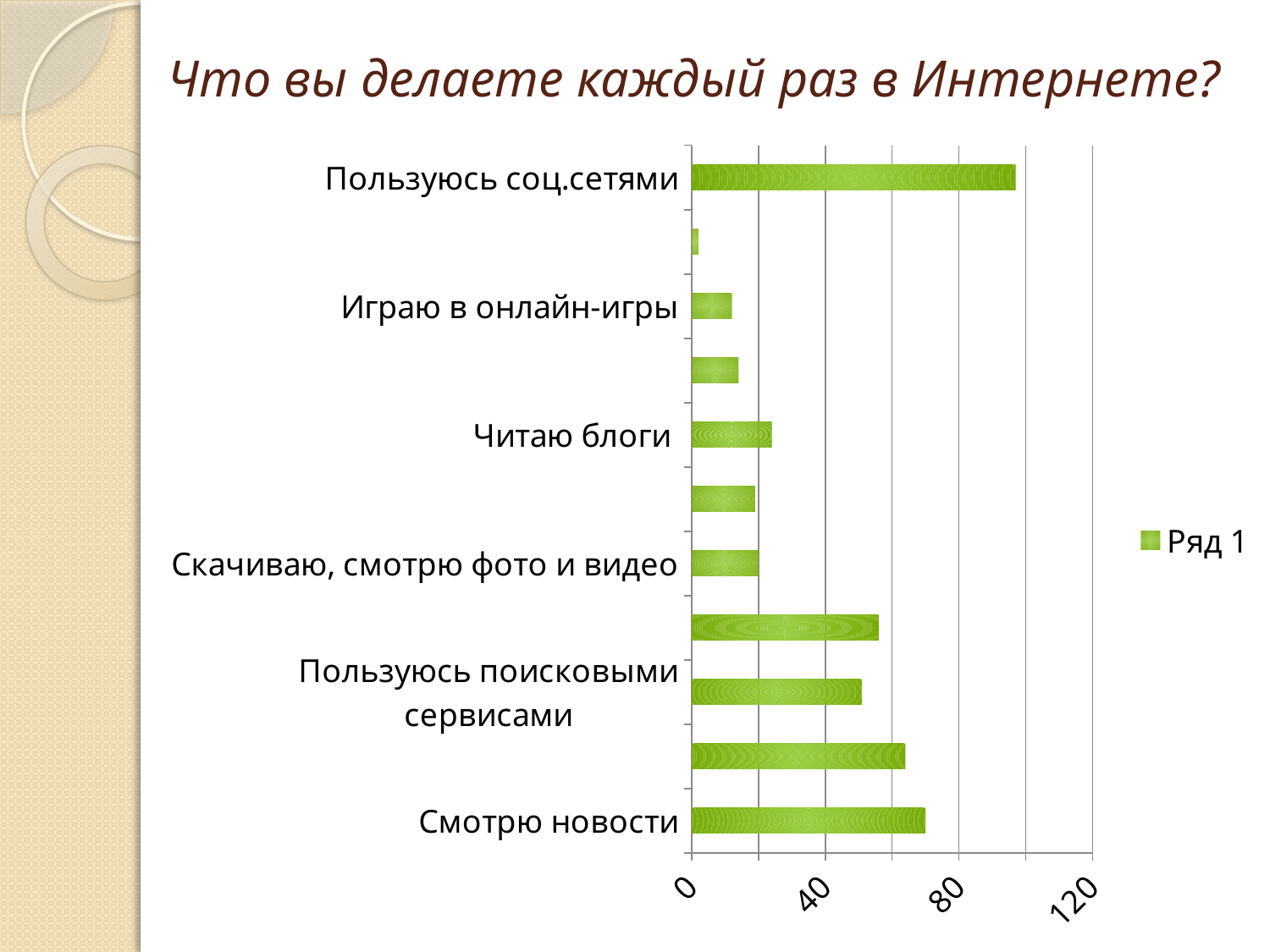
Is the value for Смотрю новости greater or less than 40? greater Is the value for Пользуюсь соц.сетями greater or less than 80? greater What is the name of the series shown in the legend? Ряд 1 Is the value for Пользуюсь поисковыми сервисами greater or less than 80? less Which is larger, the value for Пользуюсь соц.сетями or the value for Пользуюсь поисковыми сервисами? Пользуюсь соц.сетями How many bars are plotted in the chart? 11 Which labelled category has the highest value? Пользуюсь соц.сетями Which is larger, the value for Смотрю новости or the value for Читаю блоги? Смотрю новости What kind of chart is shown on the slide? bar chart What is the title of the chart? Что вы делаете каждый раз в Интернете? How many series does the legend list? 1